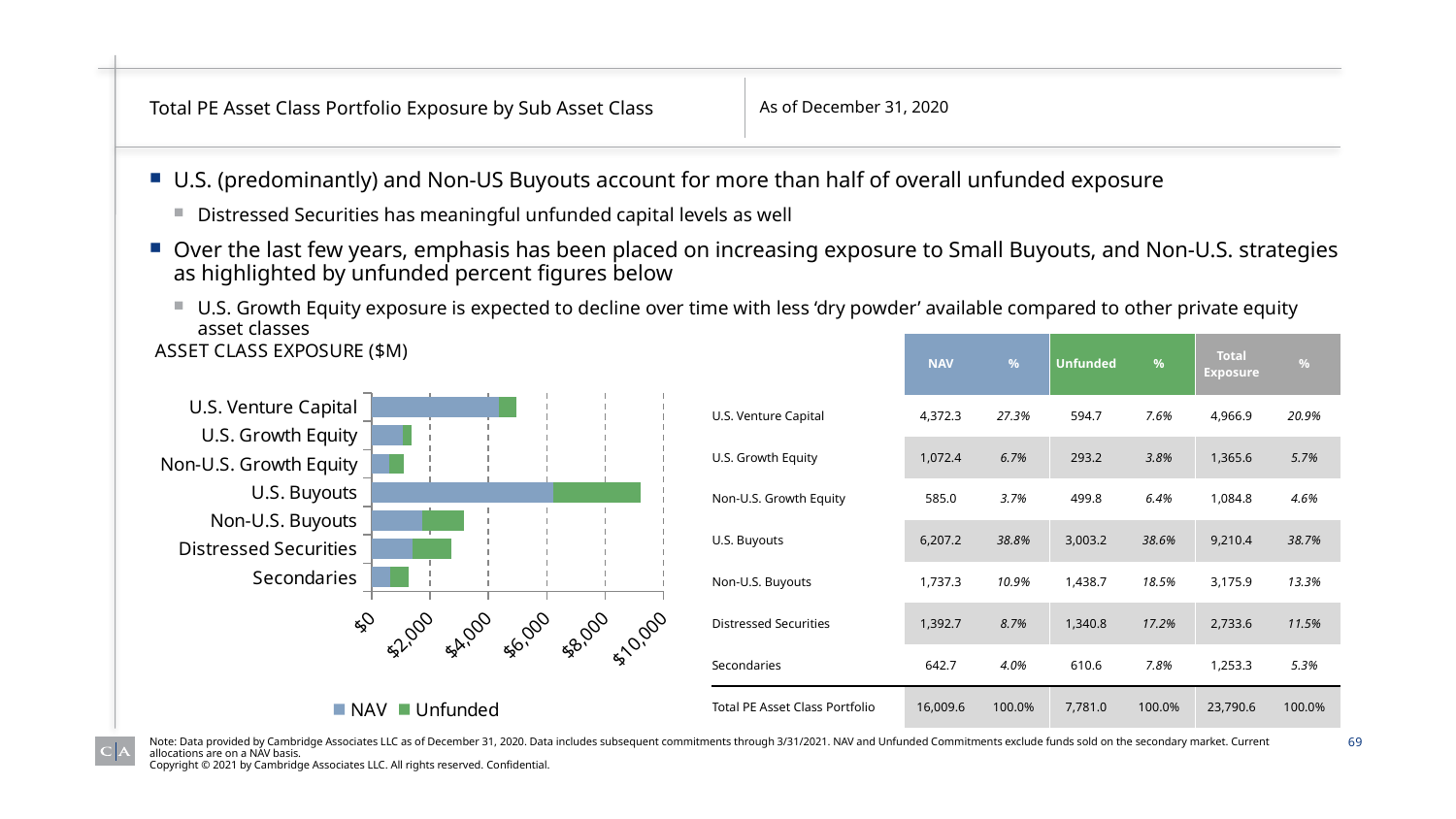
How many series does the chart legend list? 2 Which asset class has the smallest Unfunded segment on the chart? U.S. Growth Equity Which asset class has the highest NAV on the chart? U.S. Buyouts How many asset classes are plotted on the chart? 7 Which has the larger Unfunded value: Distressed Securities or U.S. Growth Equity? Distressed Securities Is the total bar length for Secondaries greater or less than $2,000? less Is the total bar length for U.S. Buyouts greater or less than $8,000? greater What is the total exposure (NAV plus Unfunded) for U.S. Buyouts, as printed in the table? 9,210.4 What kind of chart is shown on the slide? Stacked bar chart What are the two series named in the chart legend? NAV and Unfunded Is the NAV for U.S. Venture Capital greater or less than $4,000? greater What is the NAV value for Non-U.S. Buyouts, as printed in the table? 1,737.3